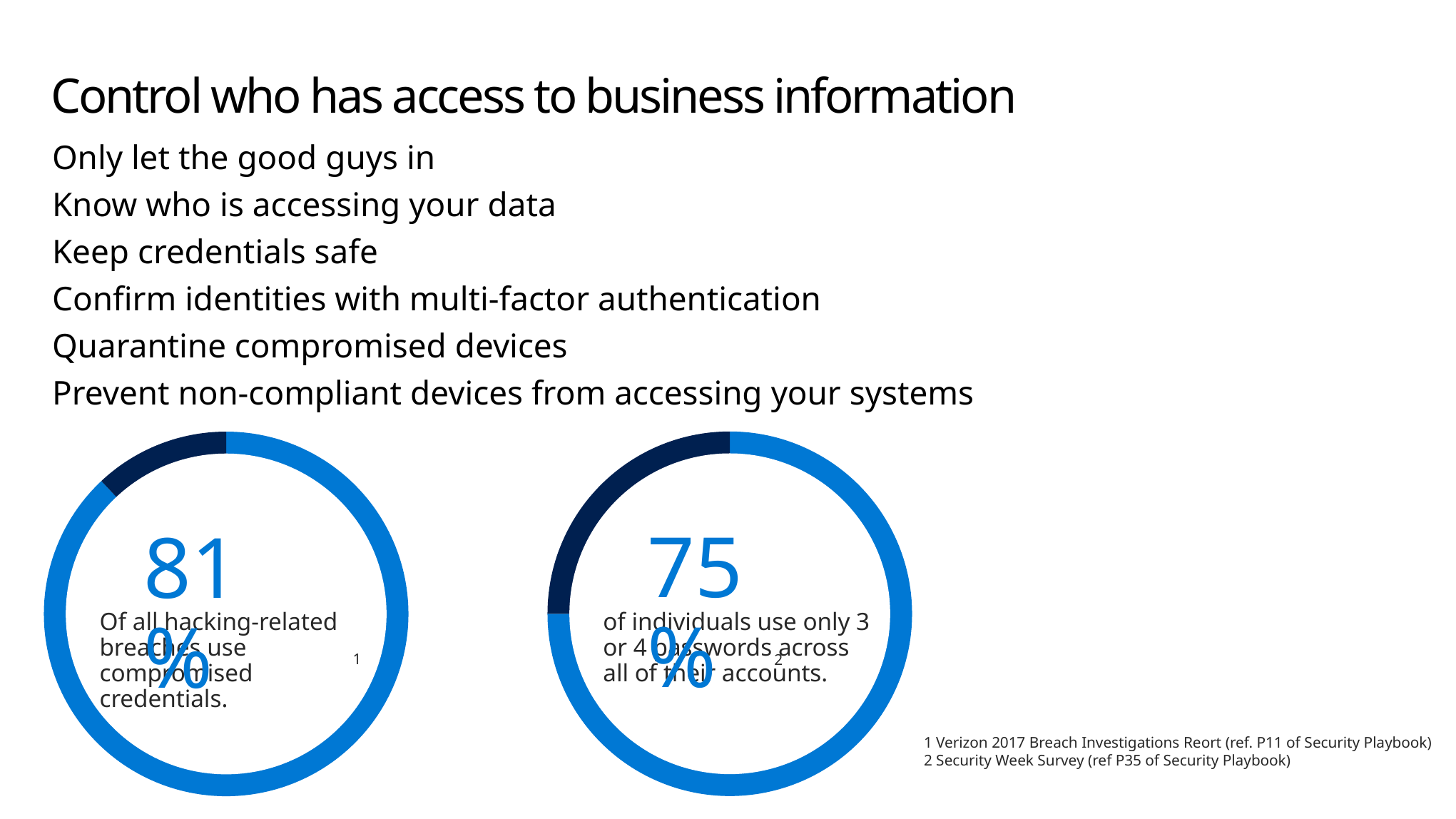
What colour is the smaller segment in each donut chart? Dark navy In the right donut chart, is the dark navy portion greater or less than 50% of the ring? less What colour is the larger segment in each donut chart? Light blue What kind of chart is the right chart on the slide? Donut chart In the right donut chart, what percentage of individuals use only 3 or 4 passwords across all of their accounts? 75% How many donut charts are shown on the slide? 2 What kind of chart is the left chart on the slide? Donut chart In the left donut chart, is the light blue portion greater or less than 50% of the ring? greater Which donut chart shows the larger percentage, the left one (hacking-related breaches) or the right one (individuals using only 3 or 4 passwords)? The left one In the left donut chart, what percentage of all hacking-related breaches use compromised credentials? 81% What is the difference between the percentage shown in the left donut chart and the percentage shown in the right donut chart? 6 percentage points